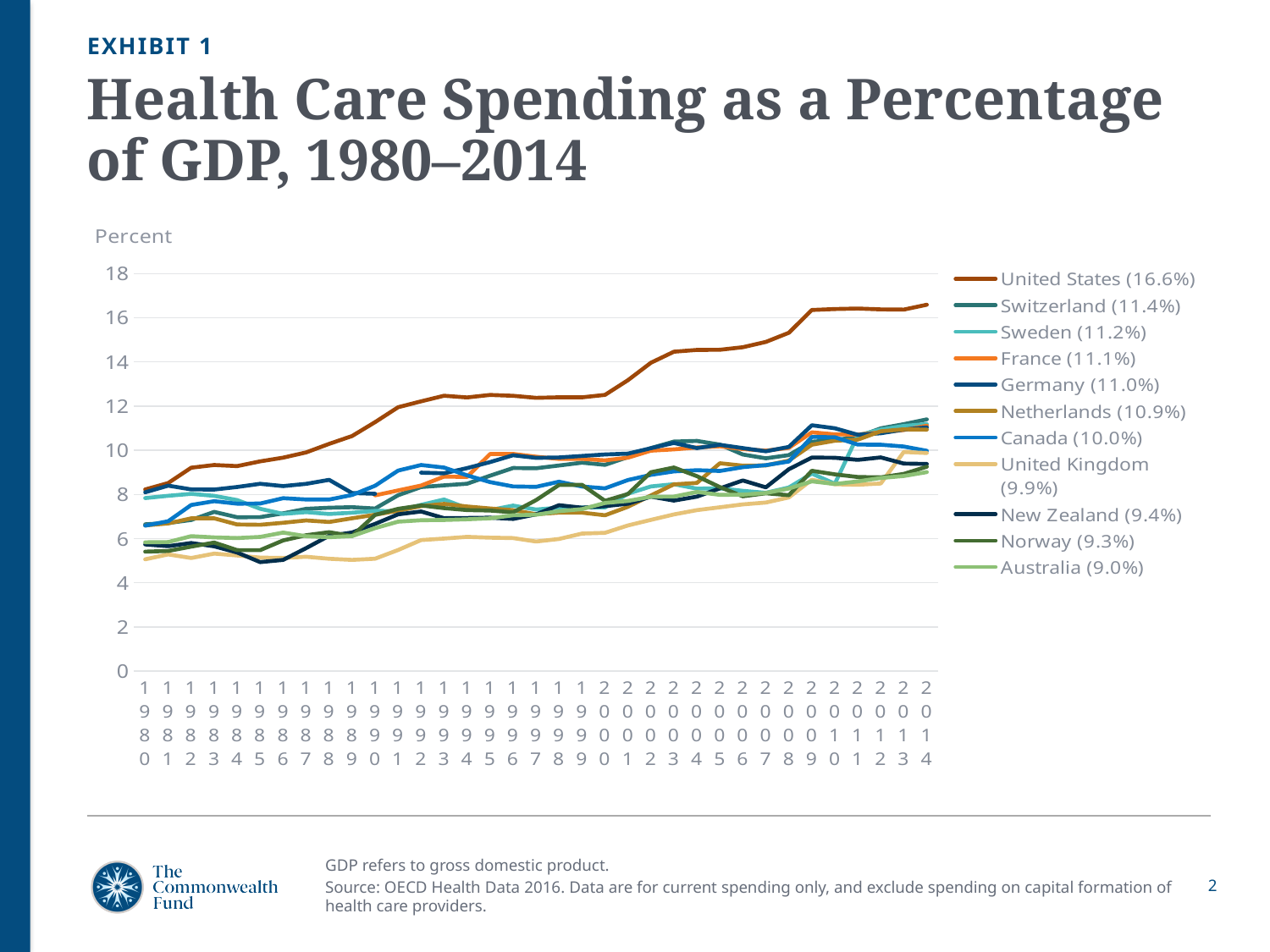
According to the legend, what percentage is shown for the United Kingdom? 9.9% According to the legend, what percentage is shown for Switzerland? 11.4% According to the legend, what percentage is shown for the United States? 16.6% Which country has the lowest percentage shown in the legend? Australia Does the United States line generally rise or fall from 1980 to 2014? Rise What is the label on the vertical axis? Percent Based on the legend percentages, which is larger: Canada or the United Kingdom? Canada What is the difference between the legend percentages for the United States and Australia? 7.6 percentage points What type of chart is shown on the slide? Line chart Is the value for the United States in 1980 greater or less than 10? less Which country has the highest percentage shown in the legend? United States How many countries (series) does the legend list? 11